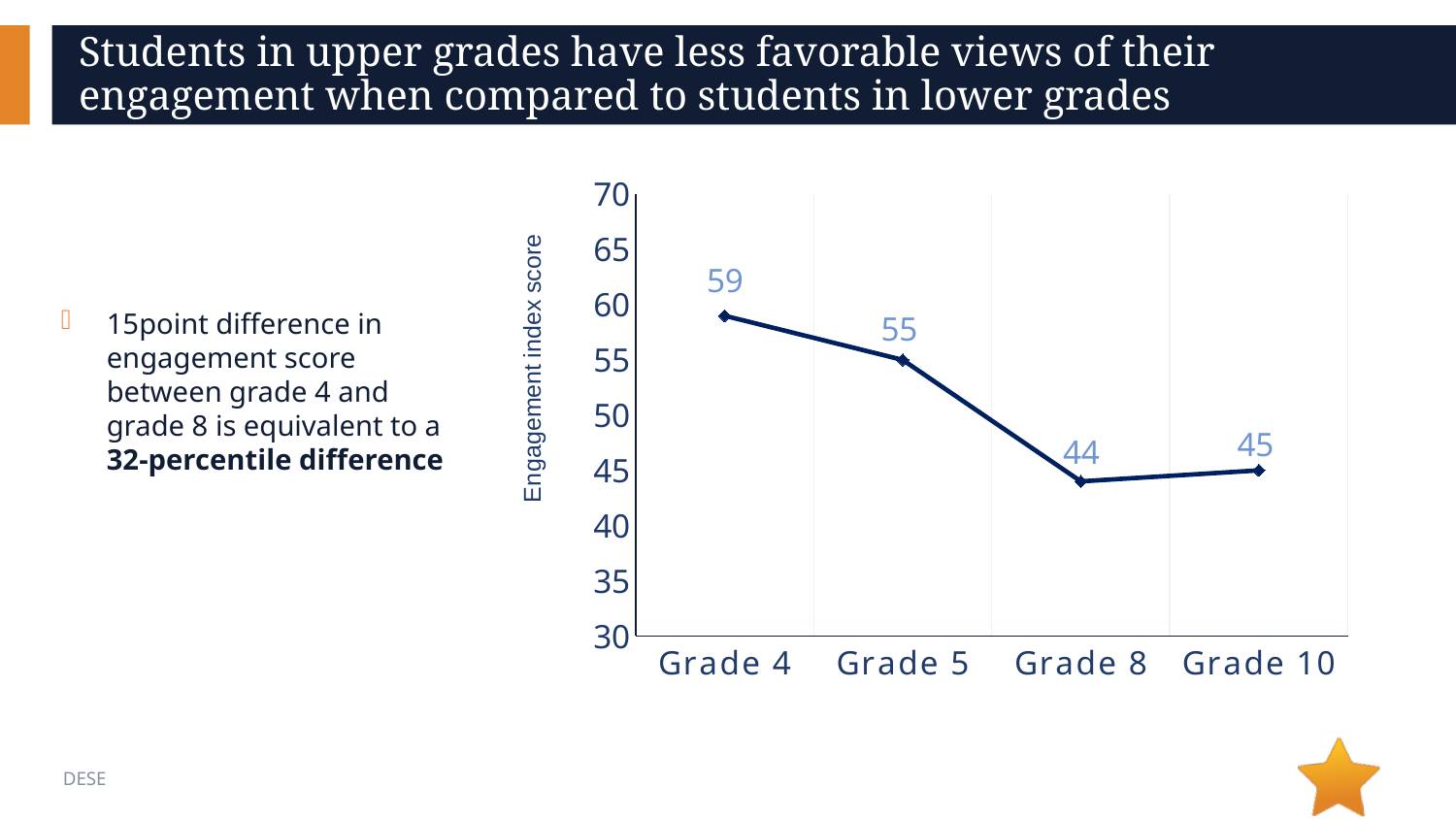
What is the engagement index score for Grade 10? 45 What is the engagement index score for Grade 8? 44 Which grade has the highest engagement index score? Grade 4 What is the label of the vertical axis? Engagement index score What is the engagement index score for Grade 4? 59 How many grades are plotted on the chart? 4 Which has a higher engagement index score, Grade 5 or Grade 10? Grade 5 What kind of chart is shown on the slide? Line chart What is the engagement index score for Grade 5? 55 What is the difference in engagement index score between Grade 4 and Grade 8? 15 What is the difference in engagement index score between Grade 5 and Grade 10? 10 Which grade has the lowest engagement index score? Grade 8